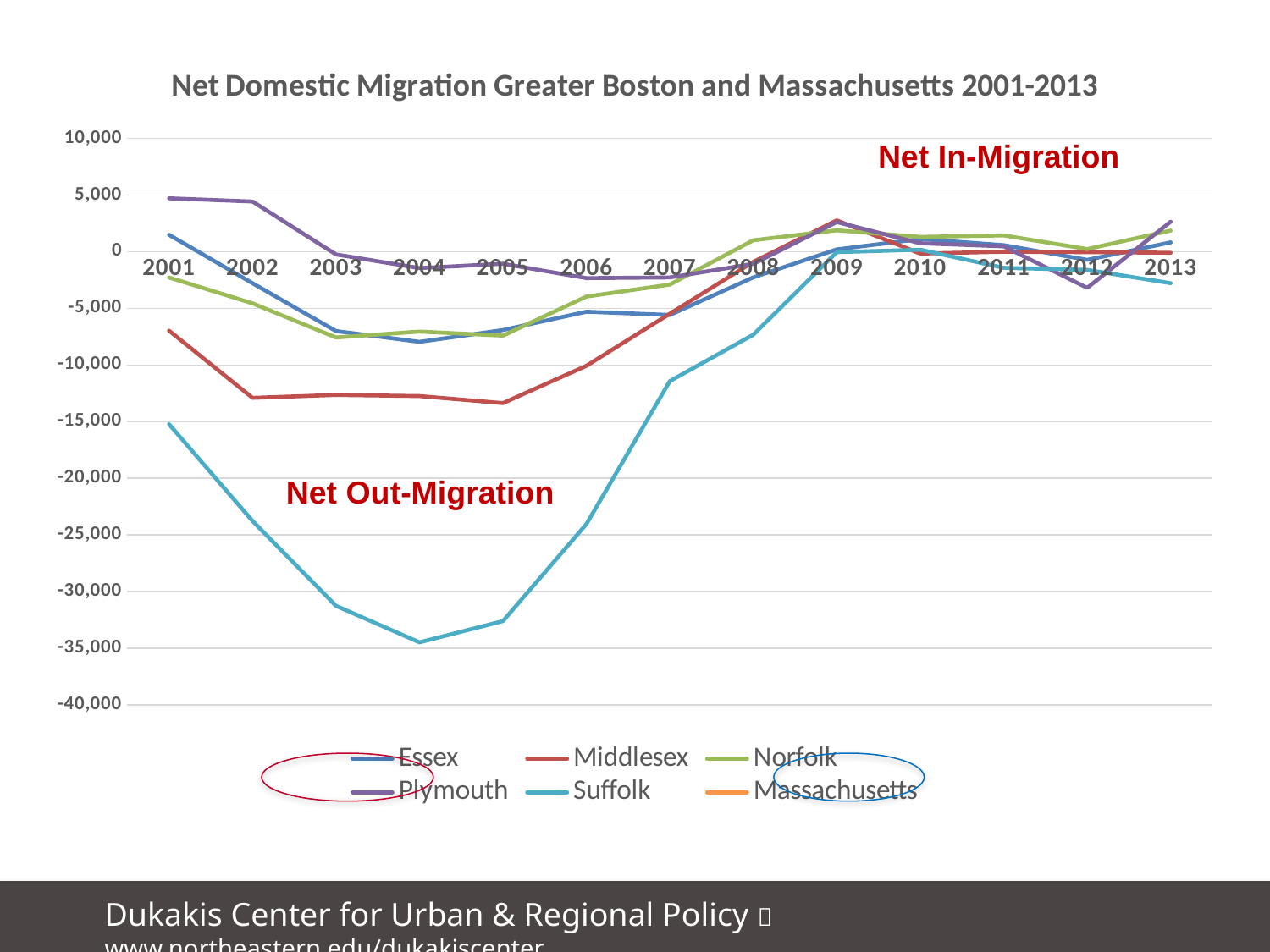
What is the title of the chart? Net Domestic Migration Greater Boston and Massachusetts 2001-2013 Which series has the lowest value in 2004? Suffolk Which is larger in 2001, the value for Middlesex or the value for Suffolk? Middlesex Which series has the highest value in 2001? Plymouth Is the value for Middlesex in 2002 greater or less than -10,000? less What kind of chart is shown on the slide? line chart How many series does the legend list? 6 Is the value for Plymouth in 2001 greater or less than 0? greater Is the value for Suffolk in 2004 greater or less than -30,000? less Does the Suffolk line rise or fall between 2004 and 2009? rise How many years are shown along the x axis? 13 In which year does the Suffolk line reach its lowest point? 2004